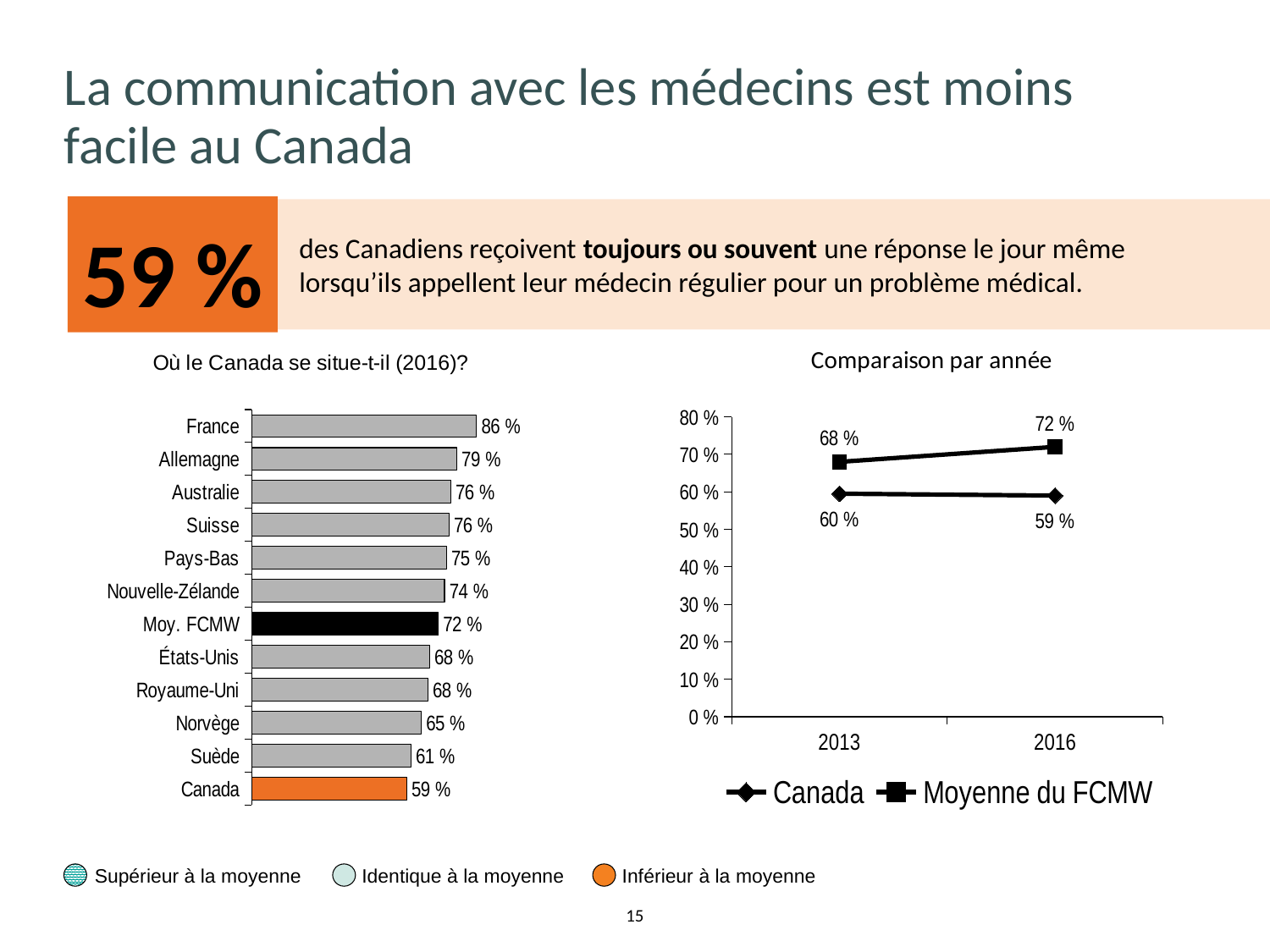
How many bars are shown in the chart 'Où le Canada se situe-t-il (2016)?'? 12 In the chart 'Comparaison par année', what is the value for Moyenne du FCMW in 2016? 72 % In the chart 'Où le Canada se situe-t-il (2016)?', which country has the highest value? France In the chart 'Où le Canada se situe-t-il (2016)?', what is the value for Moy. FCMW? 72 % In the chart 'Où le Canada se situe-t-il (2016)?', what is the difference between France and Canada? 27 % In the chart 'Où le Canada se situe-t-il (2016)?', which country has the lowest value? Canada In the chart 'Où le Canada se situe-t-il (2016)?', what is the value for France? 86 % In the chart 'Où le Canada se situe-t-il (2016)?', which is larger, the value for Norvège or the value for Suède? Norvège What kind of chart is 'Où le Canada se situe-t-il (2016)?'? Bar chart How many series does the legend of the chart 'Comparaison par année' list? 2 In the chart 'Comparaison par année', what is the value for Canada in 2013? 60 % In the chart 'Comparaison par année', does the Moyenne du FCMW series rise or fall from 2013 to 2016? Rise